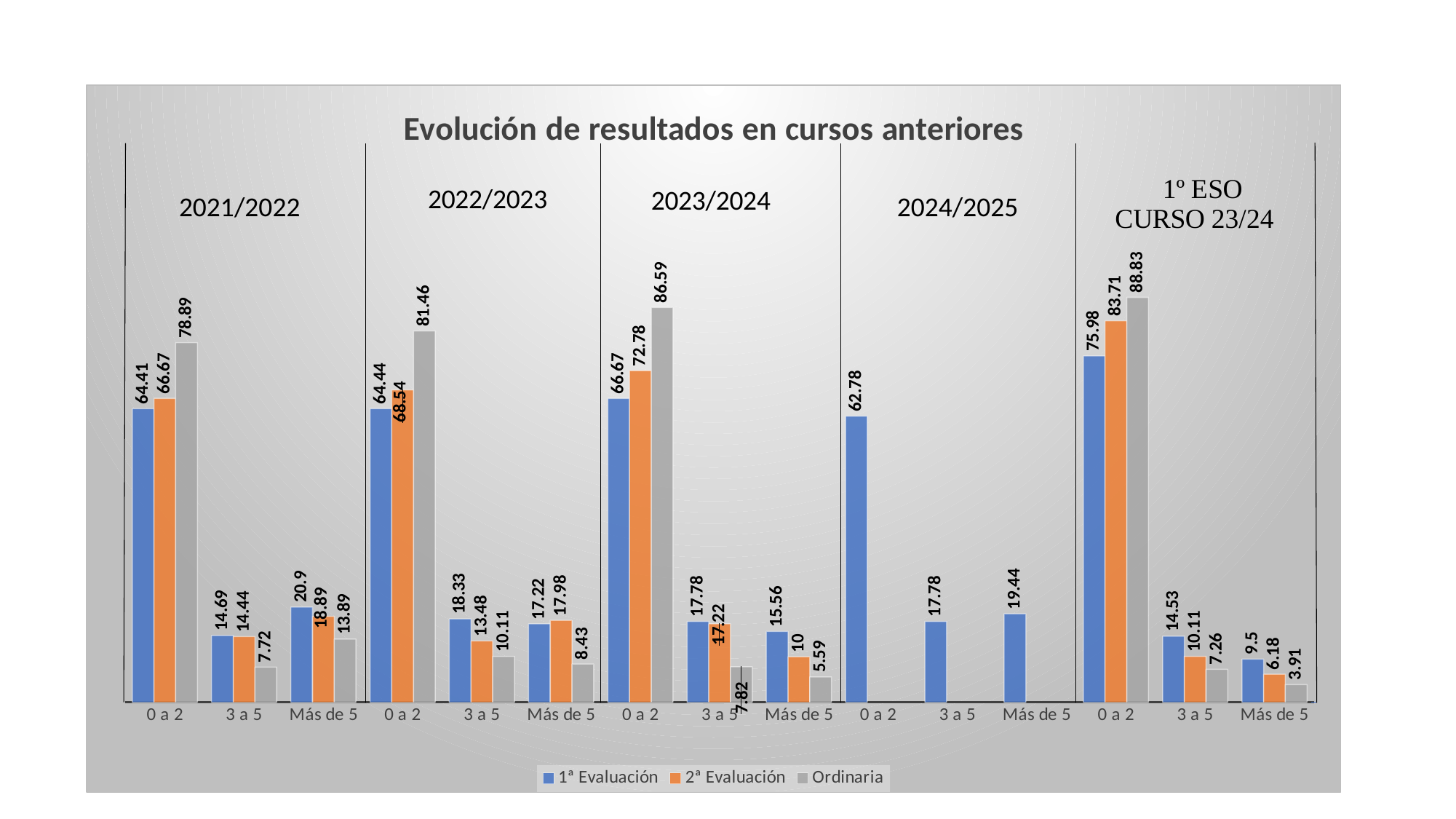
What kind of chart is shown on the slide? bar chart What is the title of the chart? Evolución de resultados en cursos anteriores How many series does the legend list? 3 What is the Ordinaria value for '0 a 2' in 2021/2022? 78.89 How many school-year groups are shown on the x axis? 5 What is the 1ª Evaluación value for 'Más de 5' in 2024/2025? 19.44 Which school year has the highest Ordinaria value for '0 a 2'? 1º ESO CURSO 23/24 What is the 2ª Evaluación value for '0 a 2' in 2022/2023? 68.54 Which is larger for '3 a 5' in 2022/2023: 1ª Evaluación or 2ª Evaluación? 1ª Evaluación Which school year has the lowest Ordinaria value for 'Más de 5'? 1º ESO CURSO 23/24 What is the difference between the Ordinaria and 1ª Evaluación values for '0 a 2' in 2023/2024? 19.92 What is the Ordinaria value for '0 a 2' in 1º ESO CURSO 23/24? 88.83